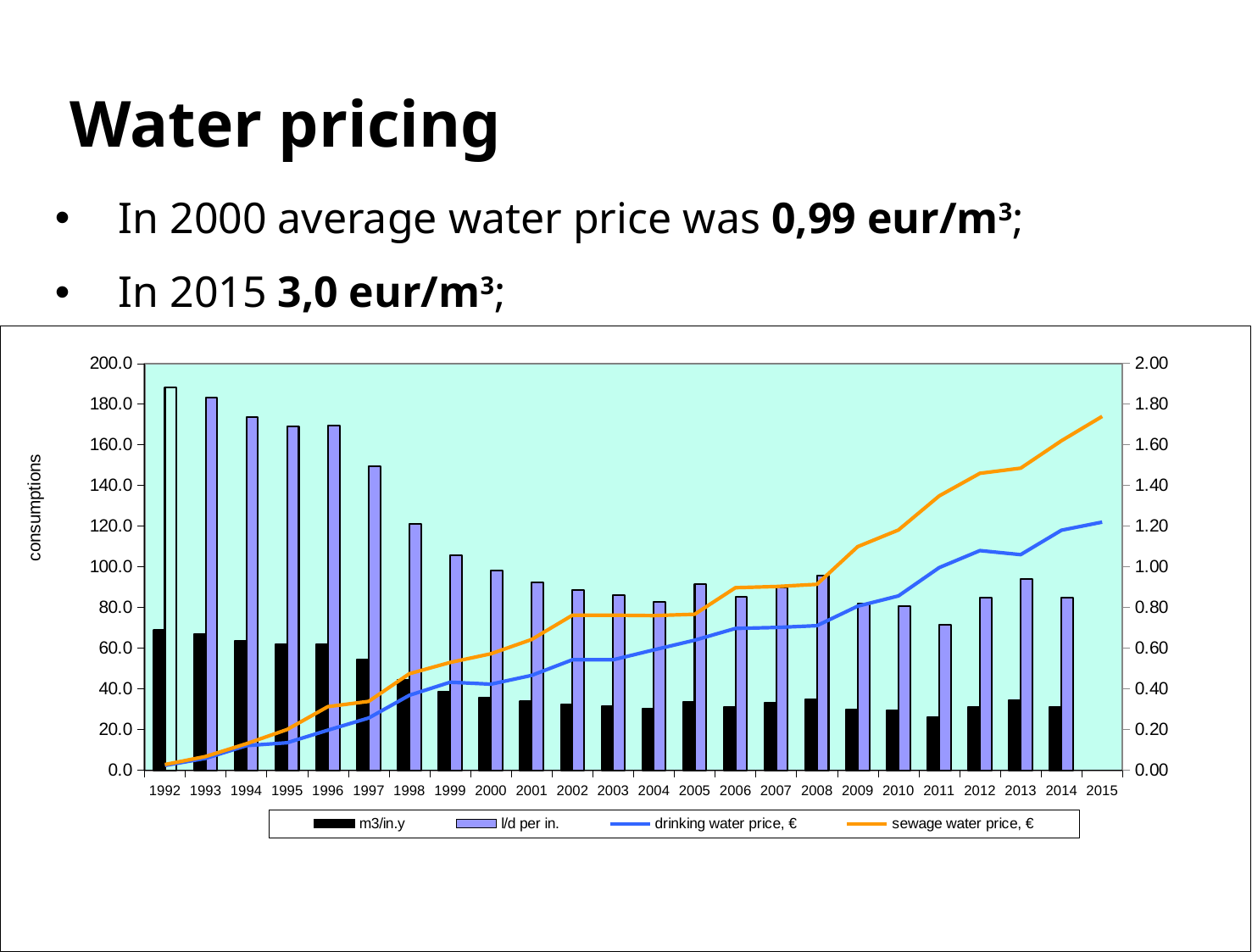
Is the sewage water price in 2015 greater or less than 1.60 on the right axis? greater Is the 'l/d per in.' value for 2011 greater or less than 80? less In which year is the 'l/d per in.' bar the highest? 1992 Does the sewage water price line rise or fall from 1992 to 2015? rise In which year is the 'm3/in.y' bar the highest? 1992 In which year is the 'l/d per in.' bar the lowest? 2011 Is the 'l/d per in.' value for 1992 greater or less than 180? greater How many years are shown along the x axis of the chart? 24 In 2015, which is higher: the sewage water price or the drinking water price? sewage water price What kind of chart is shown on the slide? A combined bar and line chart What is the label on the left vertical axis of the chart? consumptions How many series does the chart legend list? 4